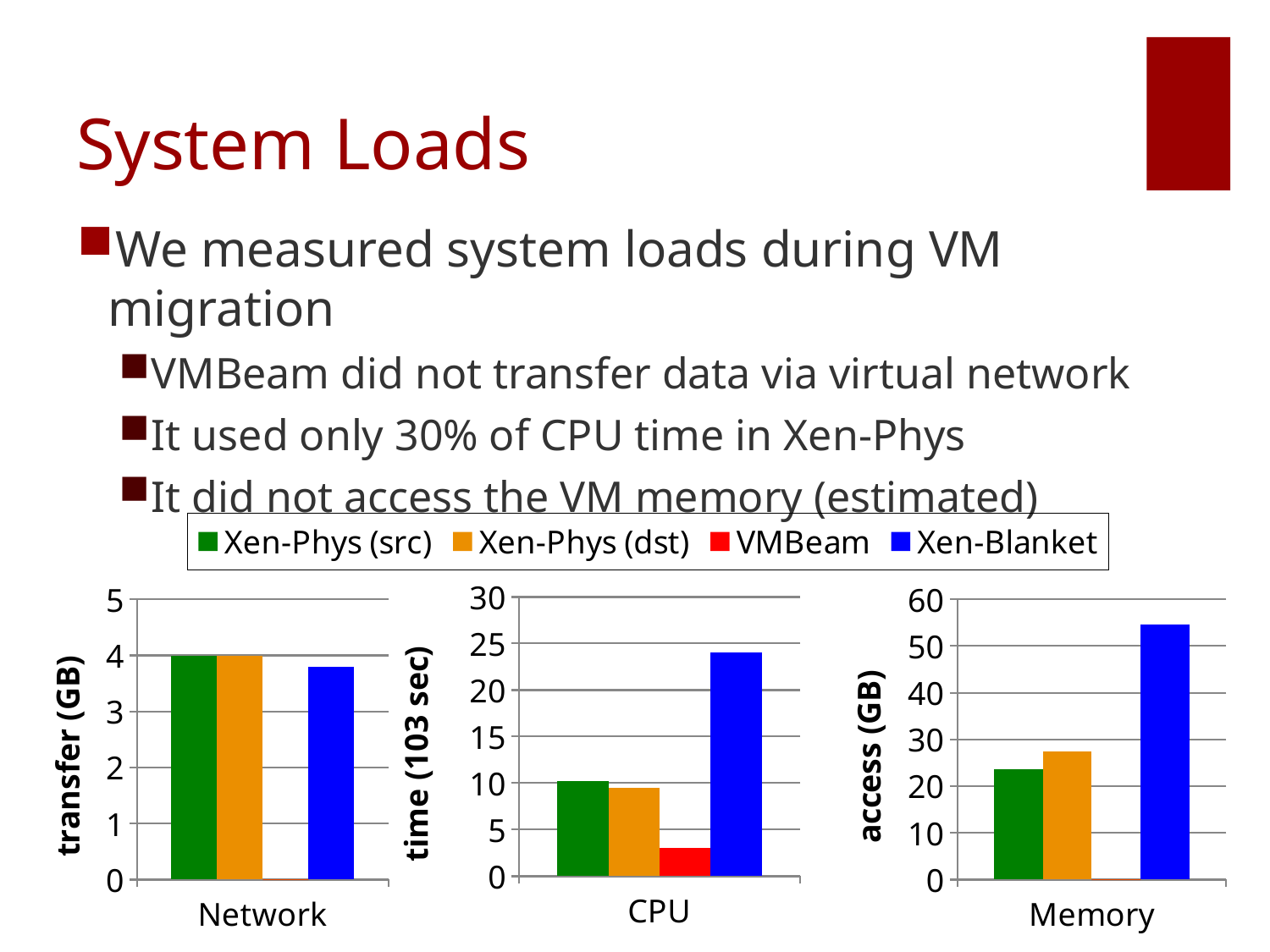
In the Memory chart, is the value for Xen-Blanket greater or less than 50? greater In the Memory chart, which series has the highest value? Xen-Blanket In the Memory chart, is the value for Xen-Phys (src) greater or less than 30? less In the CPU chart, which series has the highest value? Xen-Blanket What is the y-axis label of the Memory chart on the right? access (GB) How many series does the shared legend list? 4 In the CPU chart, is the value for VMBeam greater or less than 5? less In the Memory chart, which is larger, Xen-Phys (src) or Xen-Phys (dst)? Xen-Phys (dst) In the CPU chart, which series has the lowest value? VMBeam In the CPU chart, which is larger, Xen-Phys (src) or VMBeam? Xen-Phys (src) What kind of chart is the Network chart on the left? bar chart